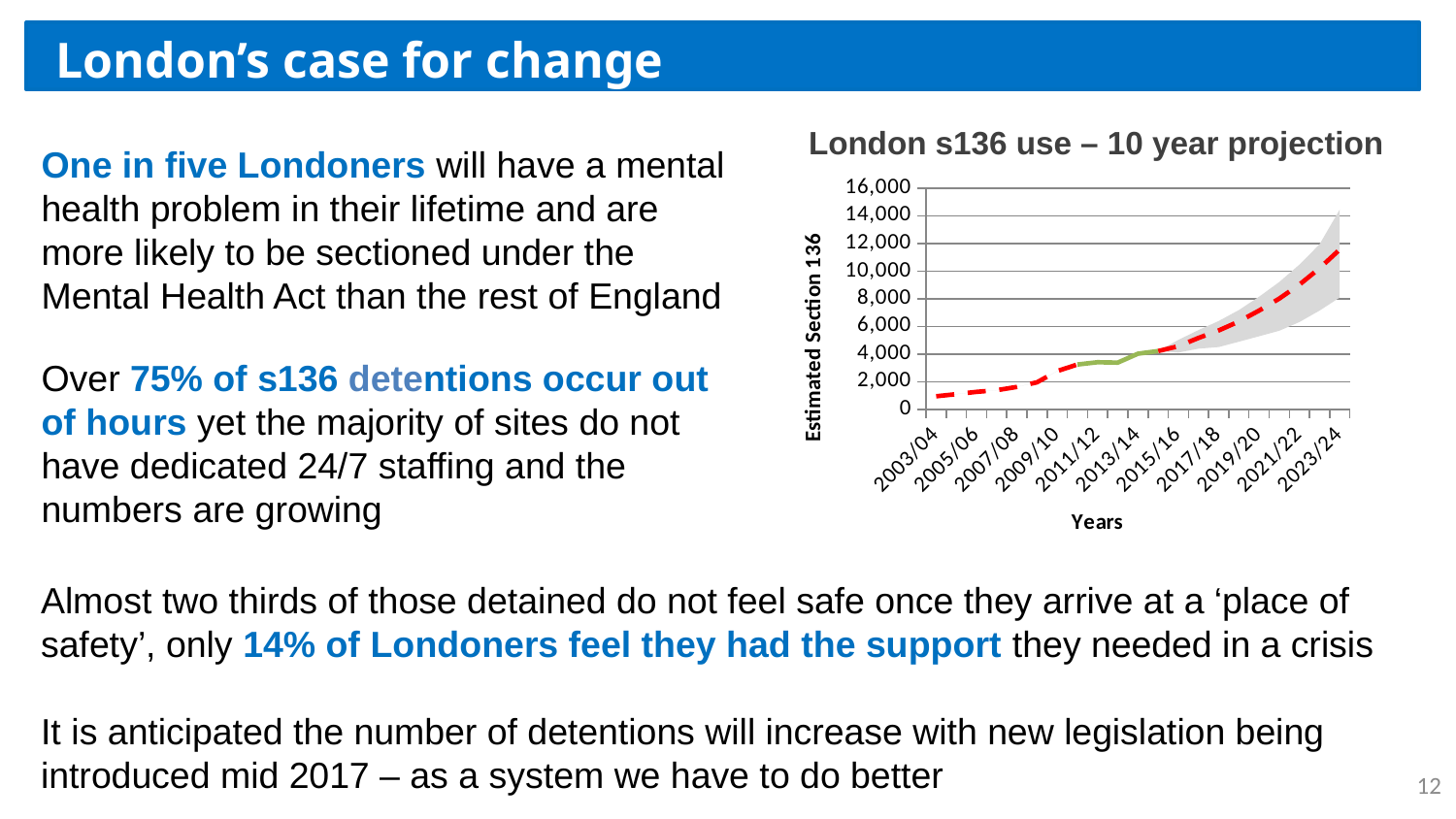
Is the value for 2023/24 greater or less than 10,000? greater Which has the larger estimated Section 136 value, 2007/08 or 2021/22? 2021/22 What kind of chart is shown on the slide? Line chart Do the estimated Section 136 values rise or fall from 2003/04 to 2023/24? Rise Is the value for 2013/14 greater or less than 6,000? less How many year labels are shown on the x axis of the chart? 11 Which year label on the x axis has the lowest estimated Section 136 value? 2003/04 Is the value for 2003/04 greater or less than 2,000? less Which year label on the x axis has the highest estimated Section 136 value? 2023/24 What is the title of the chart on the slide? London s136 use – 10 year projection What is the label on the vertical axis of the chart? Estimated Section 136